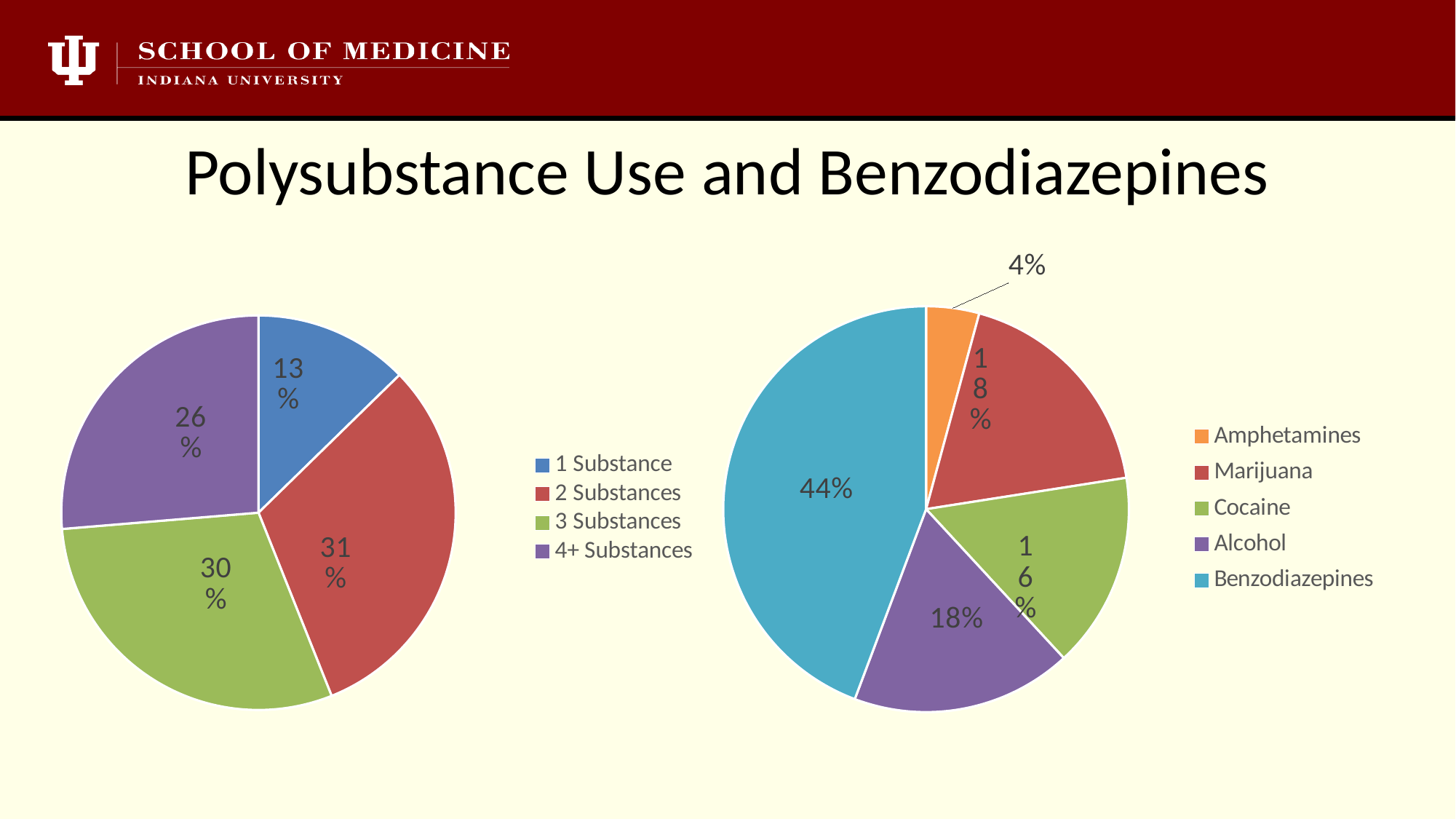
In the right pie chart, what share is labelled for Benzodiazepines? 44% In the left pie chart, what share is labelled for 4+ Substances? 26% What type of chart is the chart on the left of the slide? Pie chart In the left pie chart, which category has the smallest slice? 1 Substance In the left pie chart, what is the difference between the 2 Substances share and the 1 Substance share? 18% In the right pie chart, which is larger, the Cocaine slice or the Benzodiazepines slice? Benzodiazepines In the left pie chart, how many slices are there? 4 In the right pie chart, which category has the smallest slice? Amphetamines In the right pie chart, which category has the largest slice? Benzodiazepines In the left pie chart, what share is labelled for 1 Substance? 13% In the right pie chart, how many entries does the legend list? 5 In the right pie chart, what share is labelled for Amphetamines? 4%